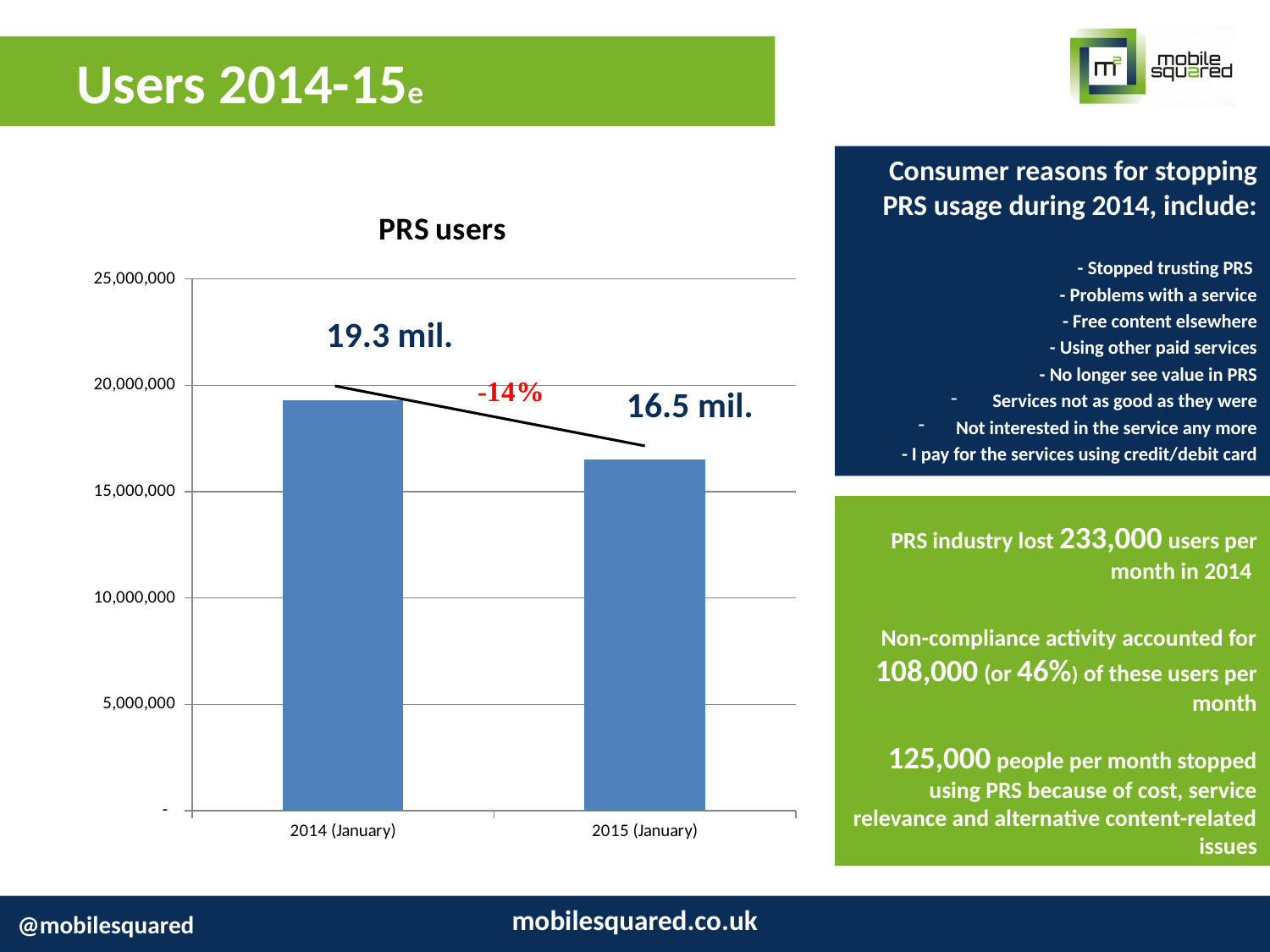
How many categories are shown on the x axis of the PRS users chart? 2 Which category has the highest value in the PRS users chart? 2014 (January) Do the values in the PRS users chart rise or fall from 2014 (January) to 2015 (January)? fall What is the difference between the 2014 (January) and 2015 (January) values in the PRS users chart? 2.8 mil. Which is larger in the PRS users chart: the value for 2014 (January) or 2015 (January)? 2014 (January) Which category has the lowest value in the PRS users chart? 2015 (January) Is the value for 2014 (January) in the PRS users chart greater or less than 15,000,000? greater What percentage change is annotated between the two bars in the PRS users chart? -14% What is the value for 2014 (January) in the PRS users chart? 19.3 mil. What kind of chart is the PRS users chart? bar chart Is the value for 2015 (January) in the PRS users chart greater or less than 20,000,000? less What is the value for 2015 (January) in the PRS users chart? 16.5 mil.